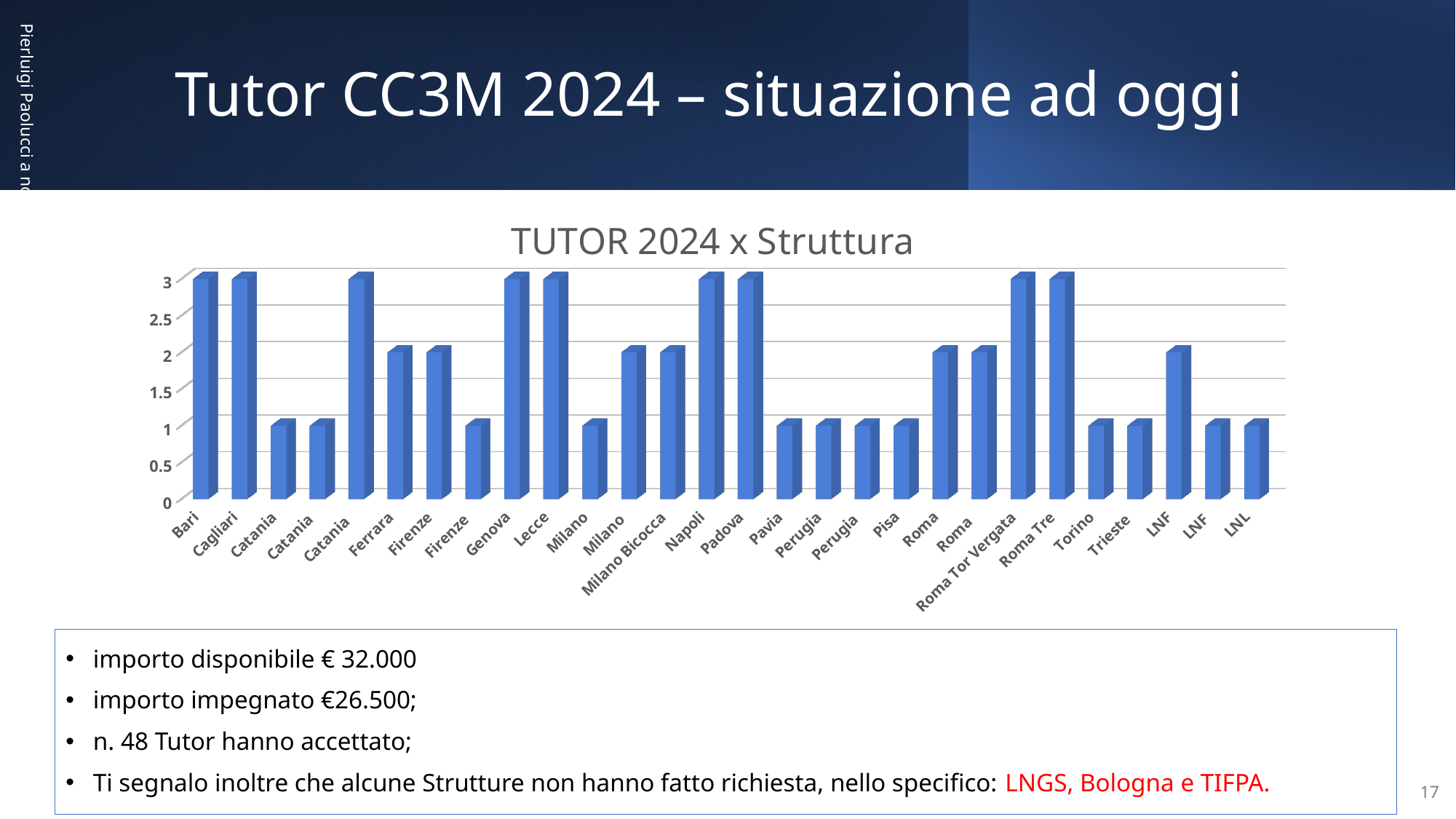
What is the value for Ferrara? 2 What is the value for LNL? 1 Which has a larger value, Genova or Trieste? Genova What is the value for Roma Tor Vergata? 3 What is the difference between the values for Napoli and Torino? 2 What is the value for Milano Bicocca? 2 How many bars are plotted in the chart? 28 What type of chart is shown on the slide? bar chart What is the value for Bari? 3 What is the value for Pavia? 1 What is the title of the chart? TUTOR 2024 x Struttura Is the value for Padova greater or less than 2? greater